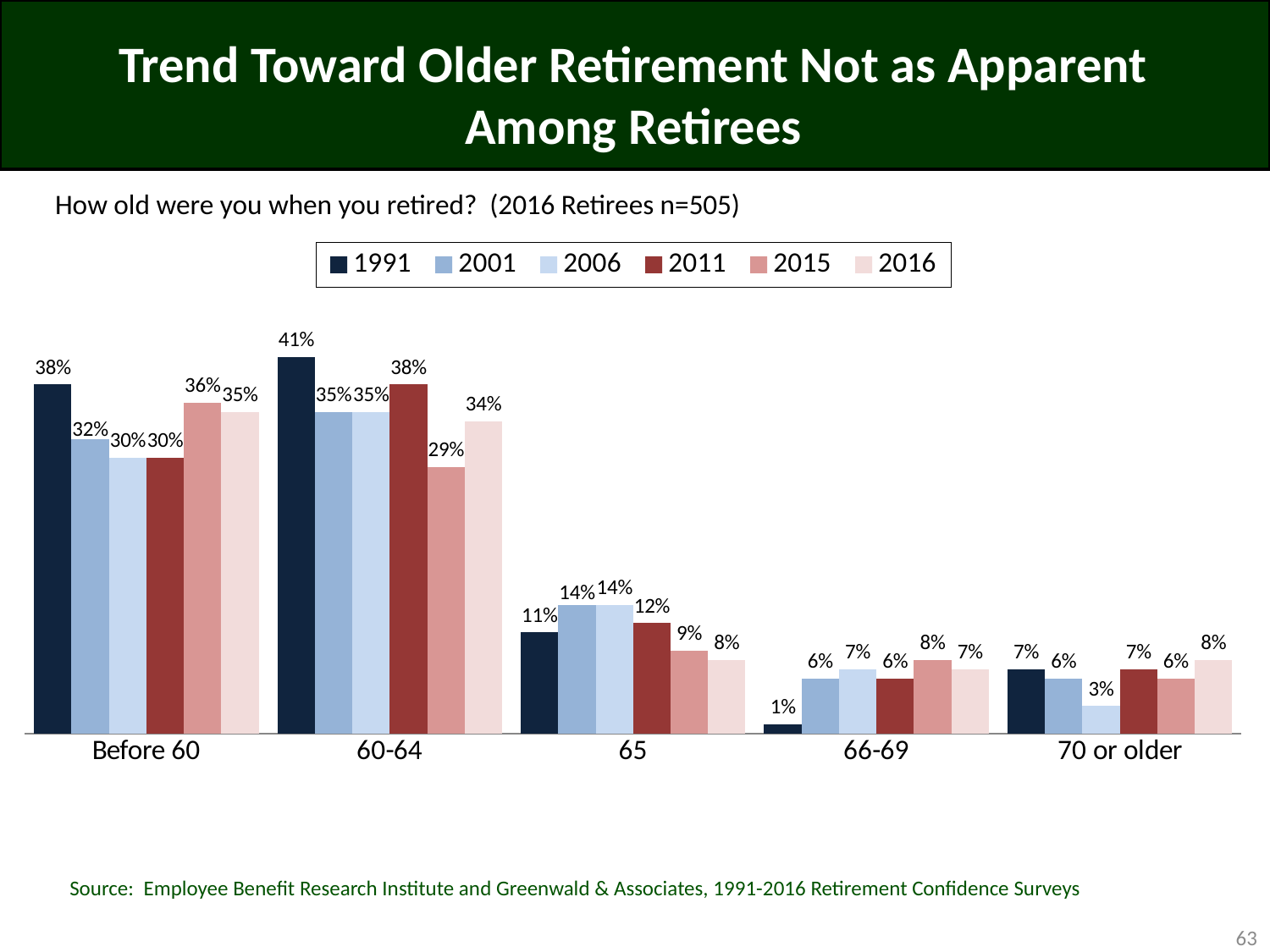
What is the value for 2006 in the '70 or older' category? 3% What percentage of retirees in 2015 retired at age 65? 9% Which is larger in the 'Before 60' category: the 2015 value or the 2001 value? 2015 What kind of chart is shown on the slide? Bar chart What percentage of retirees in 2016 said they retired before age 60? 35% How many age categories are shown on the x axis? 5 What is the sample size of 2016 retirees given in the chart subtitle? n=505 Which year has the highest value in the 60-64 category? 1991 What is the difference between the 1991 and 2015 values in the 60-64 category? 12% Which year has the lowest value in the 66-69 category? 1991 What is the value for the 1991 series in the 60-64 category? 41% How many series does the legend list? 6